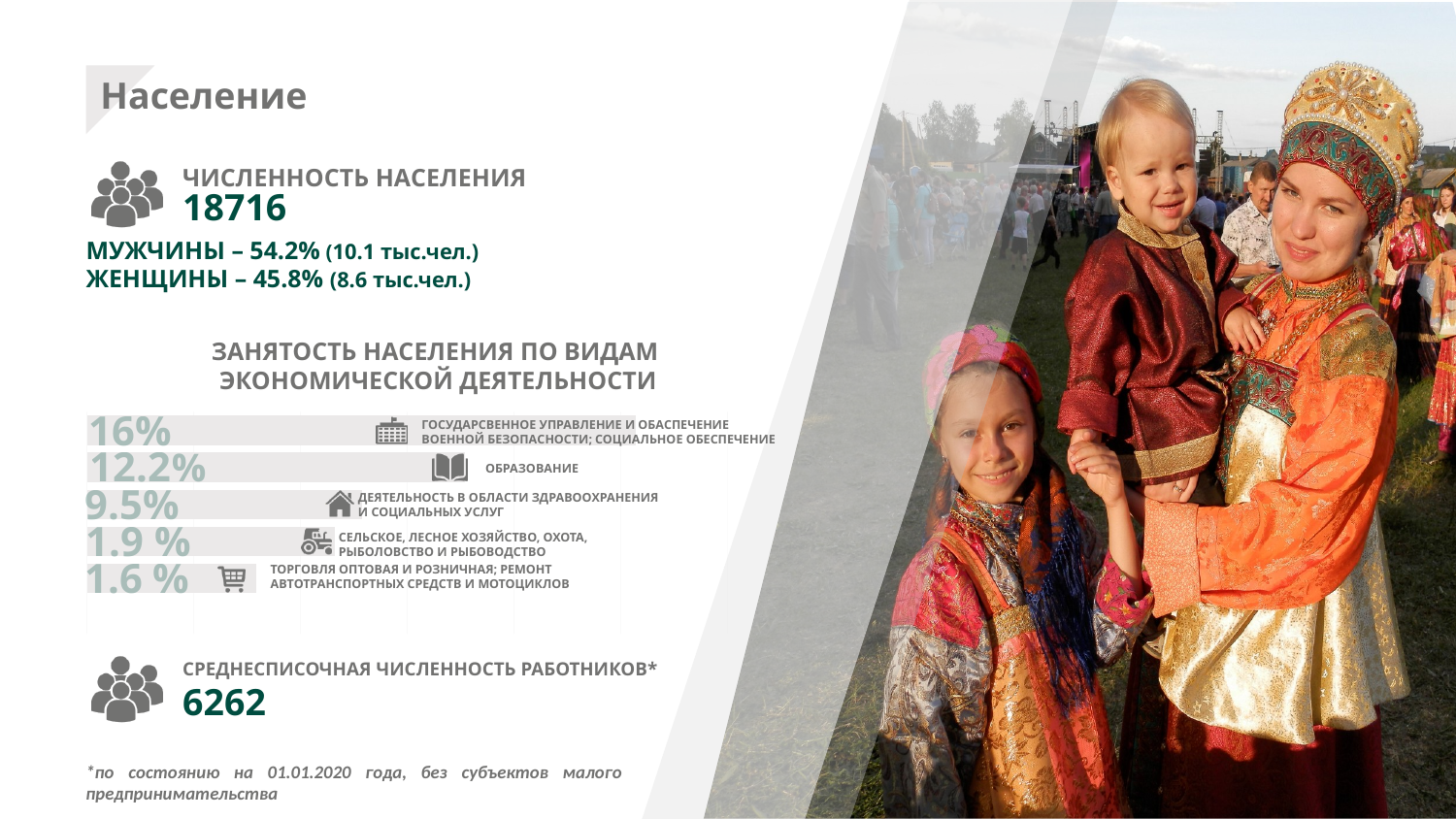
In the chart 'Занятость населения по видам экономической деятельности', what is the value for Деятельность в области здравоохранения и социальных услуг? 9.5% In the chart 'Занятость населения по видам экономической деятельности', what is the value for Торговля оптовая и розничная; ремонт автотранспортных средств и мотоциклов? 1.6 % In the chart 'Занятость населения по видам экономической деятельности', what is the difference between the values for Государственное управление and Образование? 3.8% In the chart 'Занятость населения по видам экономической деятельности', which category has the lowest value? Торговля оптовая и розничная; ремонт автотранспортных средств и мотоциклов In the chart 'Занятость населения по видам экономической деятельности', which is larger: the value for Образование or the value for Деятельность в области здравоохранения и социальных услуг? Образование In the chart 'Занятость населения по видам экономической деятельности', which category has the highest value? Государственное управление и обеспечение военной безопасности; социальное обеспечение What kind of chart is 'Занятость населения по видам экономической деятельности'? bar chart How many categories are shown in the chart 'Занятость населения по видам экономической деятельности'? 5 In the chart 'Занятость населения по видам экономической деятельности', what is the value for Сельское, лесное хозяйство, охота, рыболовство и рыбоводство? 1.9 % In the chart 'Занятость населения по видам экономической деятельности', what is the value for Образование? 12.2% In the chart 'Занятость населения по видам экономической деятельности', what is the value for Государственное управление и обеспечение военной безопасности; социальное обеспечение? 16% What is the title of the chart on the slide? Занятость населения по видам экономической деятельности